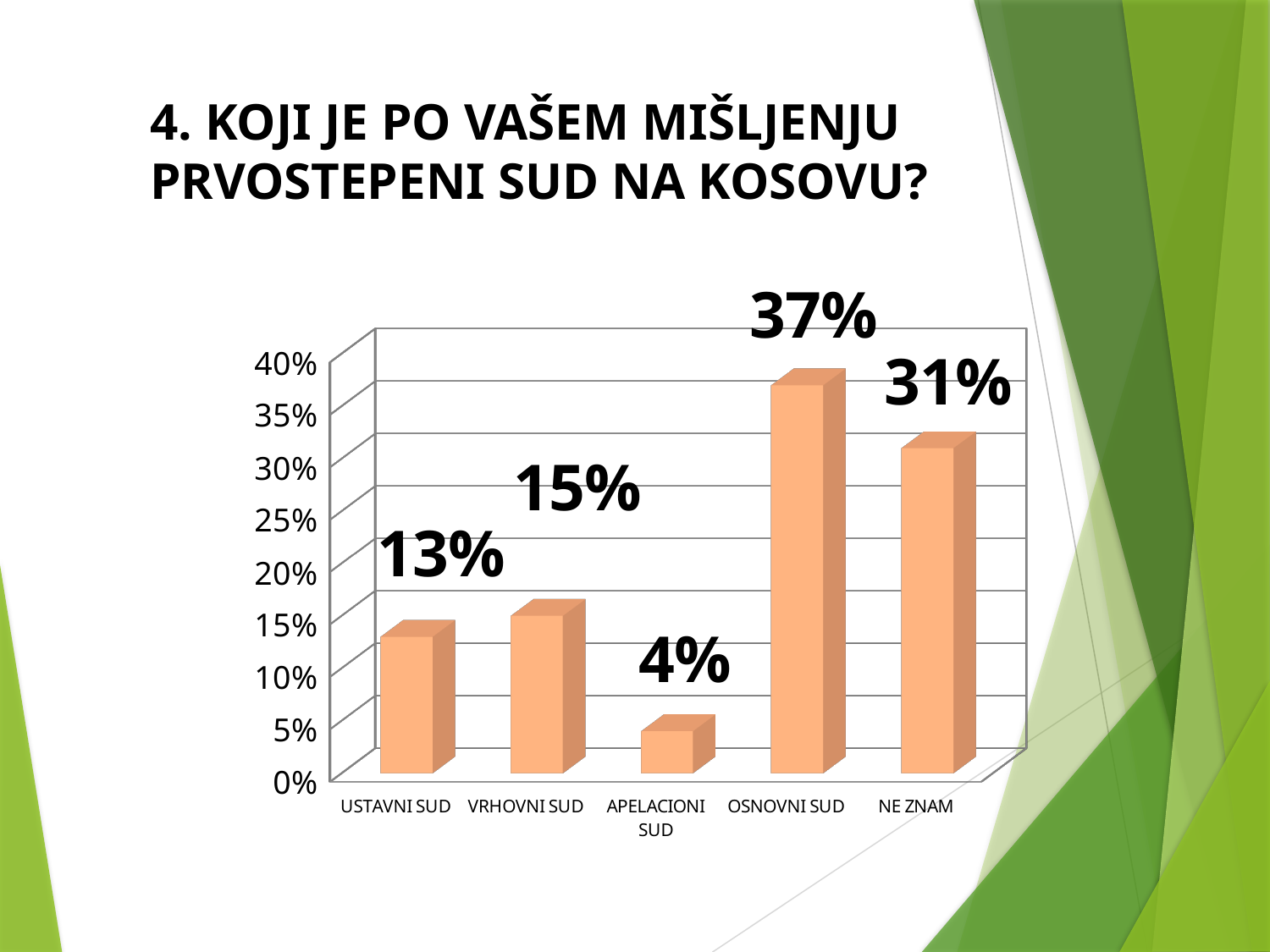
How many categories are shown on the x axis? 5 What is the title of the slide above the chart? 4. KOJI JE PO VAŠEM MIŠLJENJU PRVOSTEPENI SUD NA KOSOVU? What is the value for APELACIONI SUD? 4% What is the value for OSNOVNI SUD? 37% Which category has the highest value? OSNOVNI SUD Which is larger, the value for VRHOVNI SUD or the value for USTAVNI SUD? VRHOVNI SUD What is the value for NE ZNAM? 31% Is the value for NE ZNAM greater or less than 25%? greater Which category has the lowest value? APELACIONI SUD What is the difference between the values for OSNOVNI SUD and NE ZNAM? 6% What kind of chart is shown on the slide? bar chart What is the value for USTAVNI SUD? 13%